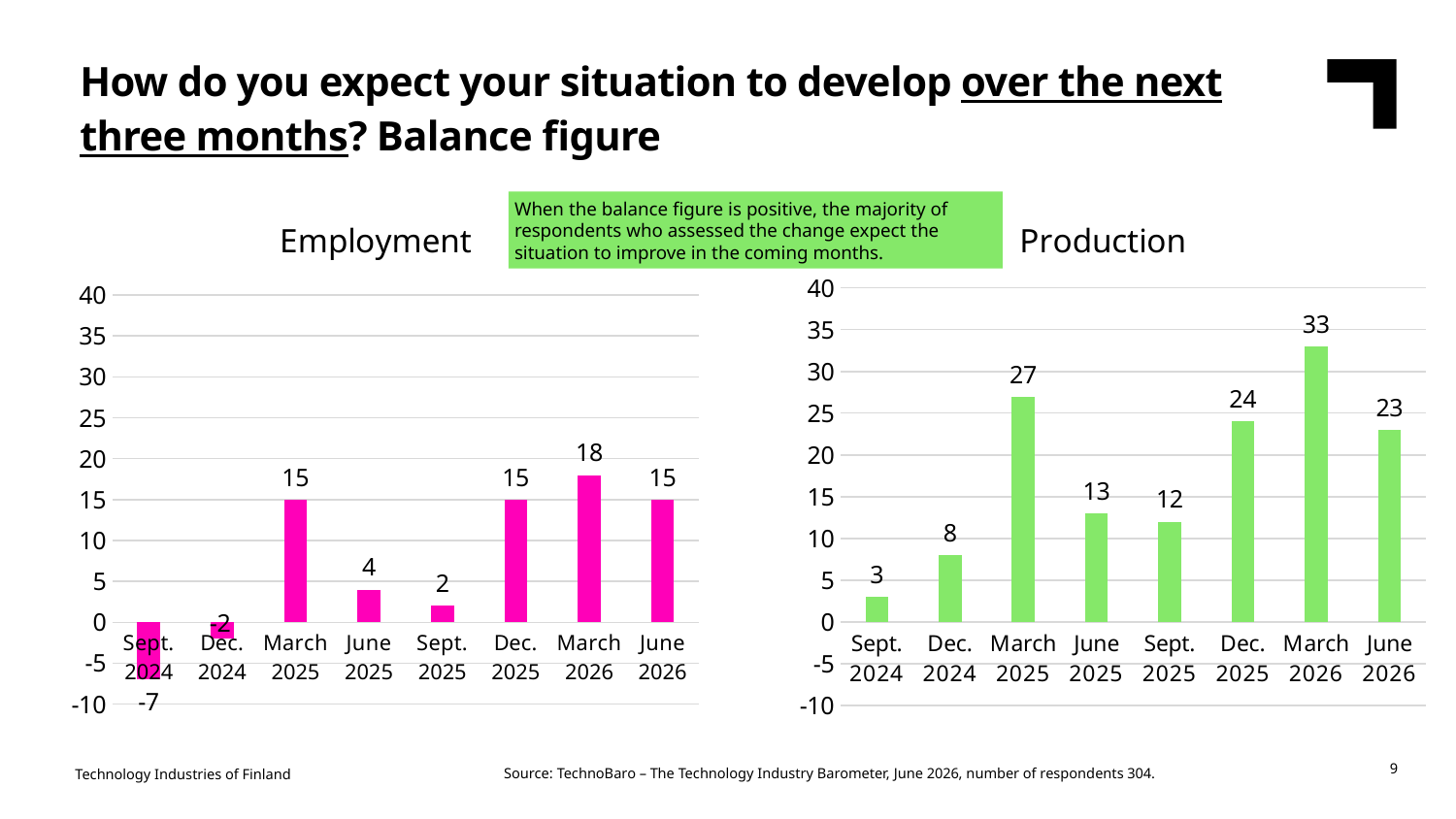
How many periods are shown on the x axis of the Production chart? 8 What kind of chart is the Employment chart? Bar chart In the Production chart, which period has the lowest value? Sept. 2024 In the Production chart, what is the difference between the values for March 2026 and June 2026? 10 In the Employment chart, what is the value for March 2026? 18 In the Employment chart, which period has the lowest value? Sept. 2024 In the Employment chart, what is the difference between the values for March 2025 and June 2025? 11 In the Production chart, which period has the highest value? March 2026 Which is larger: the Production value for June 2025 or for Sept. 2025? June 2025 What colour are the bars in the Production chart? Green In the Production chart, what is the value for Dec. 2025? 24 In the Employment chart, what is the value for Sept. 2024? -7